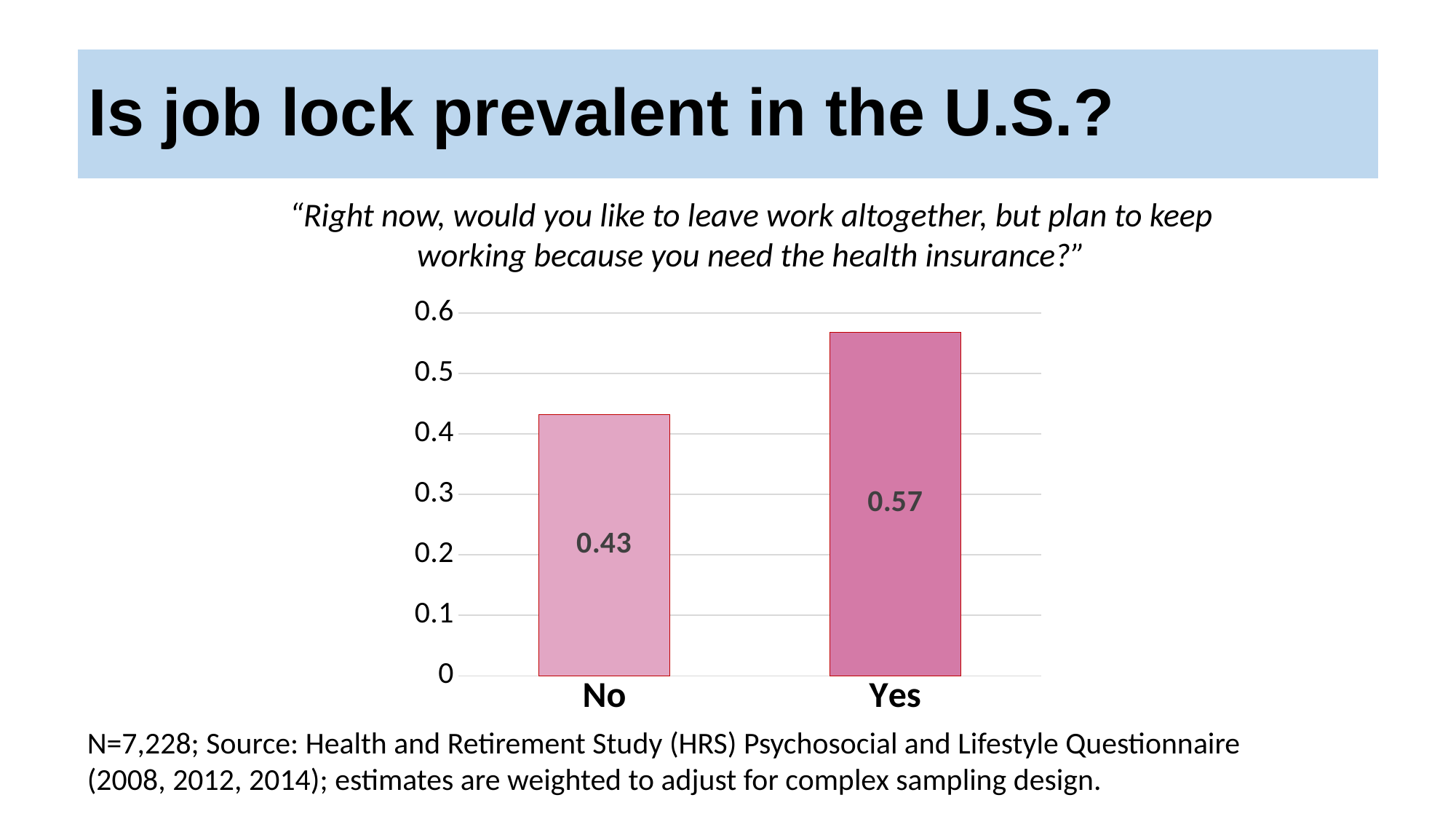
How many categories are shown in the chart? 2 What is the value for the "Yes" bar? 0.57 What is the difference between the "Yes" and "No" values? 0.14 What is the sample size (N) stated below the chart? 7,228 Is the value for "Yes" greater or less than 0.5? greater Is the value for "No" greater or less than 0.5? less What is the value for the "No" bar? 0.43 Which is larger, the value for "No" or the value for "Yes"? Yes Which category has the highest value? Yes What kind of chart is shown on the slide? Bar chart Which category has the lowest value? No What is the total of the two bar values? 1.00